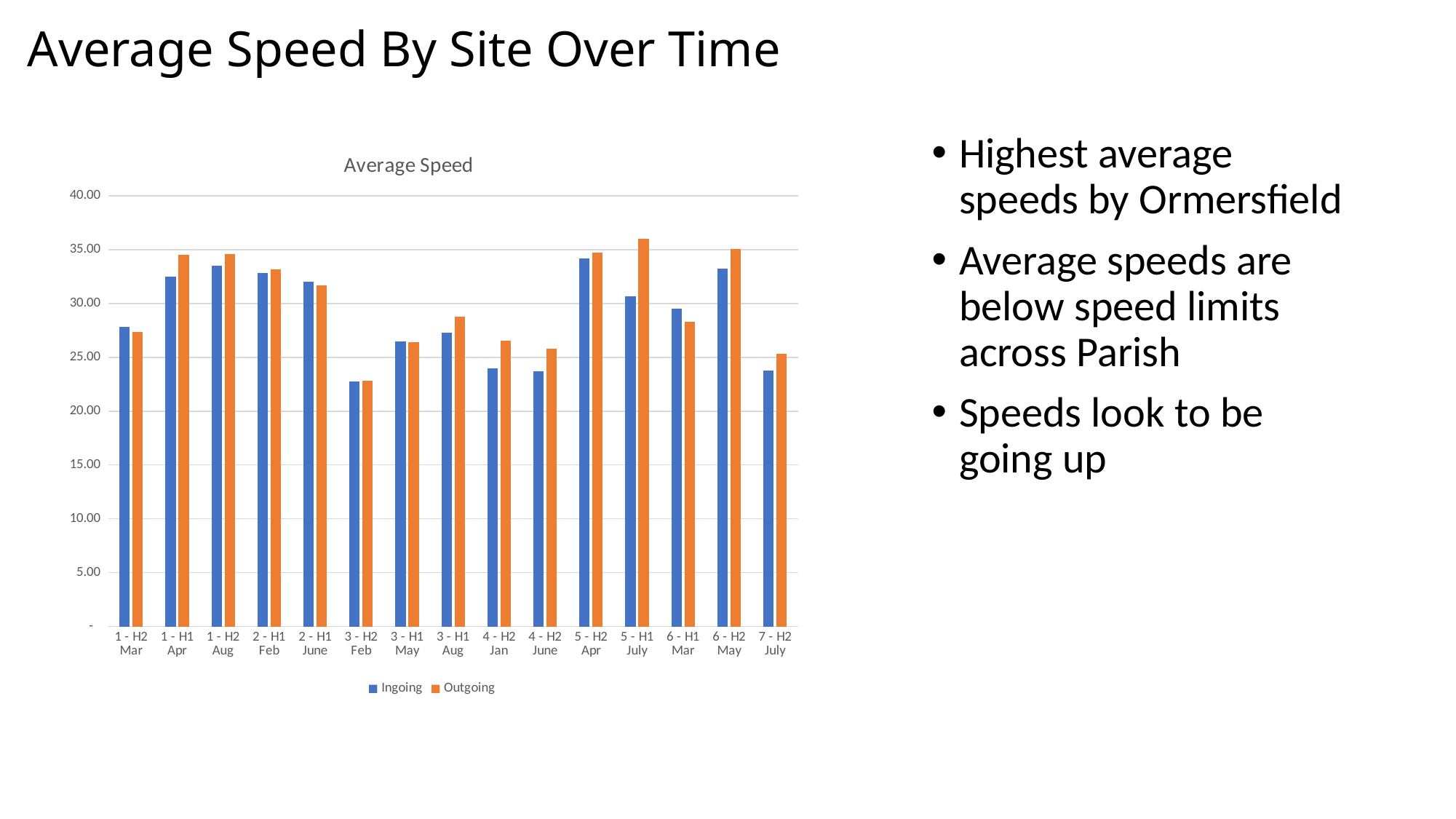
Is the Outgoing value for 3 - H1 Aug greater or less than 25.00? greater What kind of chart is shown on the slide? Bar chart Is the Ingoing value for 3 - H2 Feb greater or less than 25.00? less Is the Outgoing value for 5 - H1 July greater or less than 35.00? greater Which category has the lowest Ingoing value? 3 - H2 Feb For 5 - H1 July, which is larger: the Ingoing or the Outgoing value? Outgoing How many series does the chart's legend list? 2 Which category has the highest Outgoing value? 5 - H1 July What is the title of the chart? Average Speed How many categories are shown along the x axis of the chart? 15 For 1 - H1 Apr, which is larger: the Ingoing or the Outgoing value? Outgoing